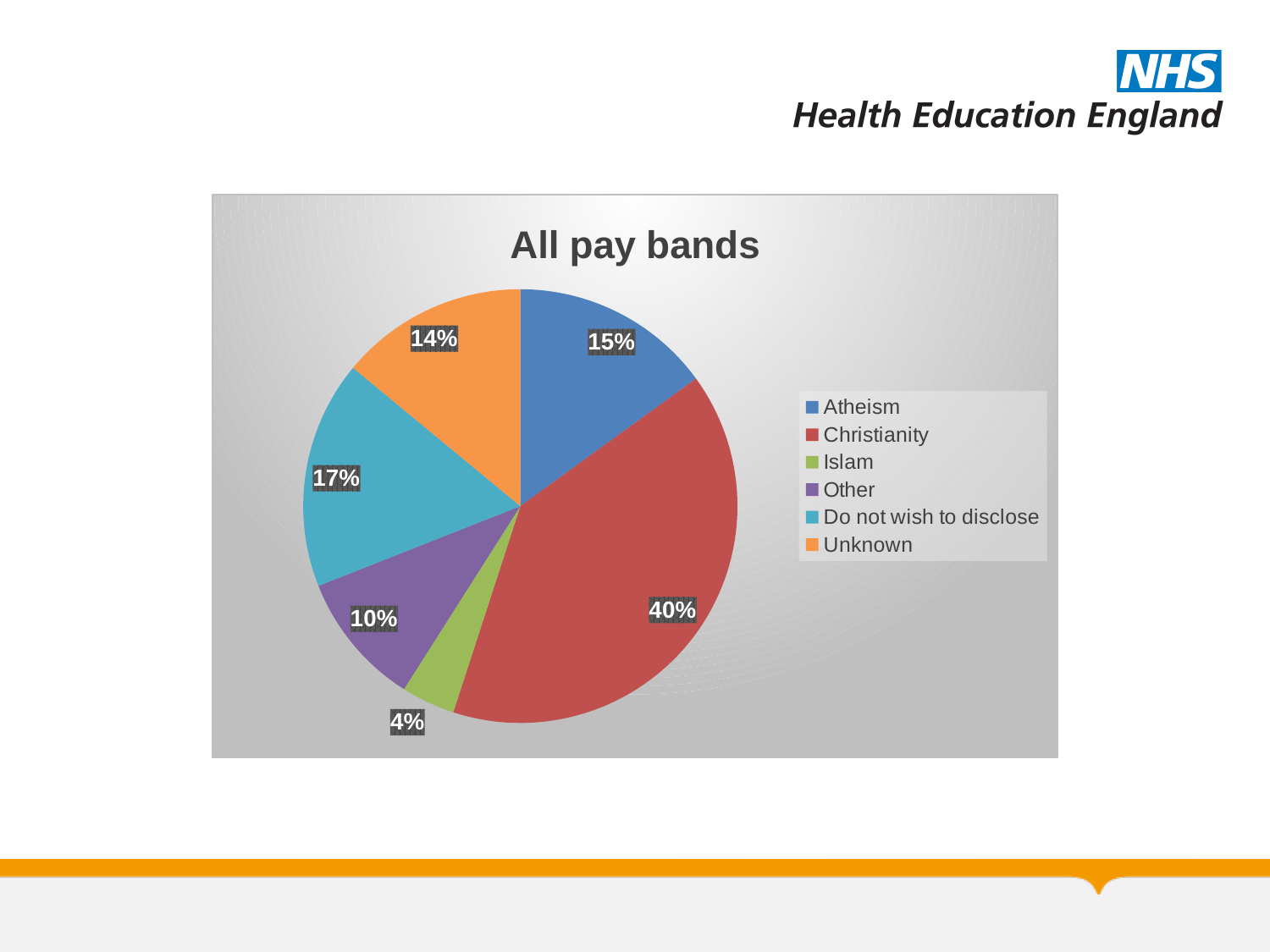
Which category has the smallest share of the pie? Islam What is the title of the chart? All pay bands How many categories does the legend list? 6 Which is larger, the share for Unknown or the share for Other? Unknown What percentage of the pie is Christianity? 40% What percentage of the pie is Atheism? 15% What percentage of the pie is Do not wish to disclose? 17% What percentage of the pie is Islam? 4% What colour is the Do not wish to disclose slice? Light blue Which category has the largest share of the pie? Christianity What type of chart is shown on the slide? Pie chart What is the difference in percentage points between Christianity and Atheism? 25